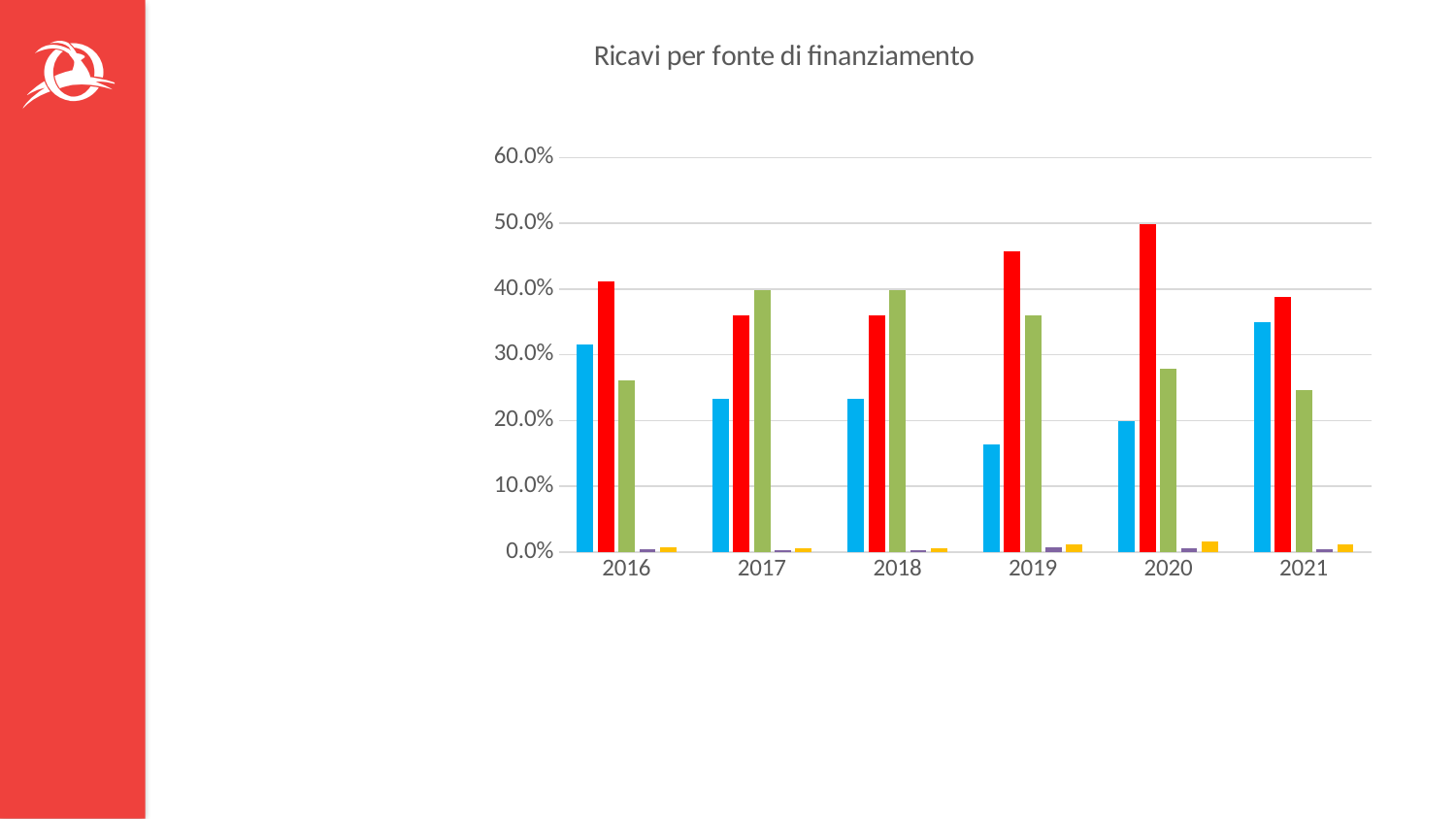
In 2019, which is larger, the red bar or the green bar? the red bar What kind of chart is shown on the slide? bar chart Is the value of the blue bar for 2021 greater or less than 30.0%? greater In which year is the blue bar the tallest? 2021 Is the value of the blue bar for 2019 greater or less than 20.0%? less How many bars are plotted for each year in the chart? 5 In which year is the blue bar the shortest? 2019 What is the title of the chart? Ricavi per fonte di finanziamento In which year is the red bar the tallest? 2020 Is the value of the red bar for 2020 greater or less than 40.0%? greater How many years are shown on the x axis of the chart? 6 In 2016, which is larger, the blue bar or the green bar? the blue bar